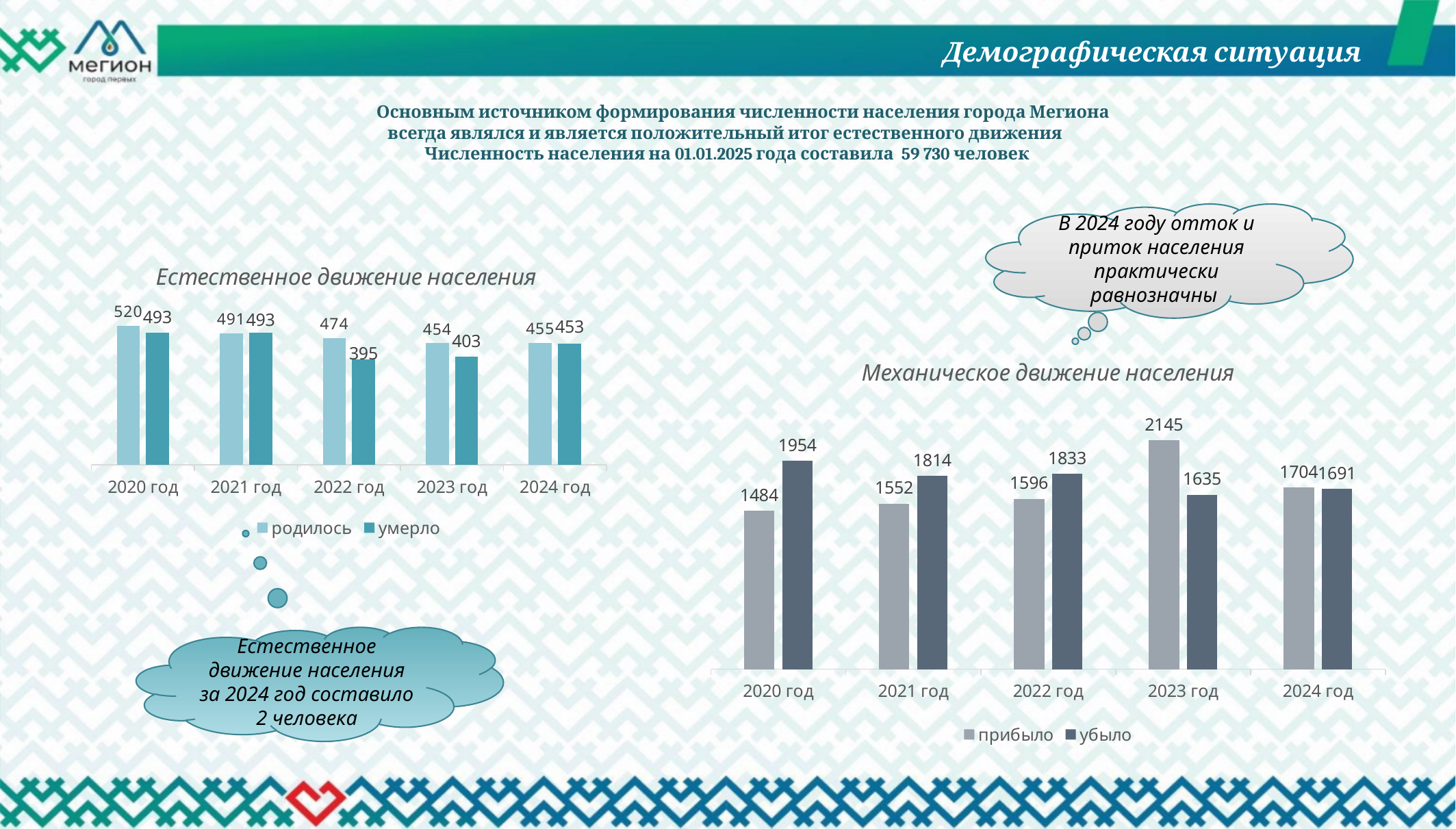
In the chart 'Естественное движение населения', what is the value for 'родилось' in 2020 год? 520 In the chart 'Естественное движение населения', which year has the lowest value for 'умерло'? 2022 год In the chart 'Естественное движение населения', what is the difference between 'родилось' and 'умерло' in 2022 год? 79 In the chart 'Механическое движение населения', which is larger in 2021 год: 'прибыло' or 'убыло'? убыло In the chart 'Механическое движение населения', how many years are shown on the x axis? 5 In the chart 'Механическое движение населения', what is the value for 'убыло' in 2020 год? 1954 In the chart 'Естественное движение населения', what is the value for 'умерло' in 2022 год? 395 In the chart 'Механическое движение населения', which year has the highest value for 'прибыло'? 2023 год What type of chart is 'Механическое движение населения'? Bar chart In the chart 'Механическое движение населения', what is the value for 'прибыло' in 2023 год? 2145 In the chart 'Естественное движение населения', how many series does the legend list? 2 In the chart 'Механическое движение населения', what is the difference between 'убыло' and 'прибыло' in 2020 год? 470